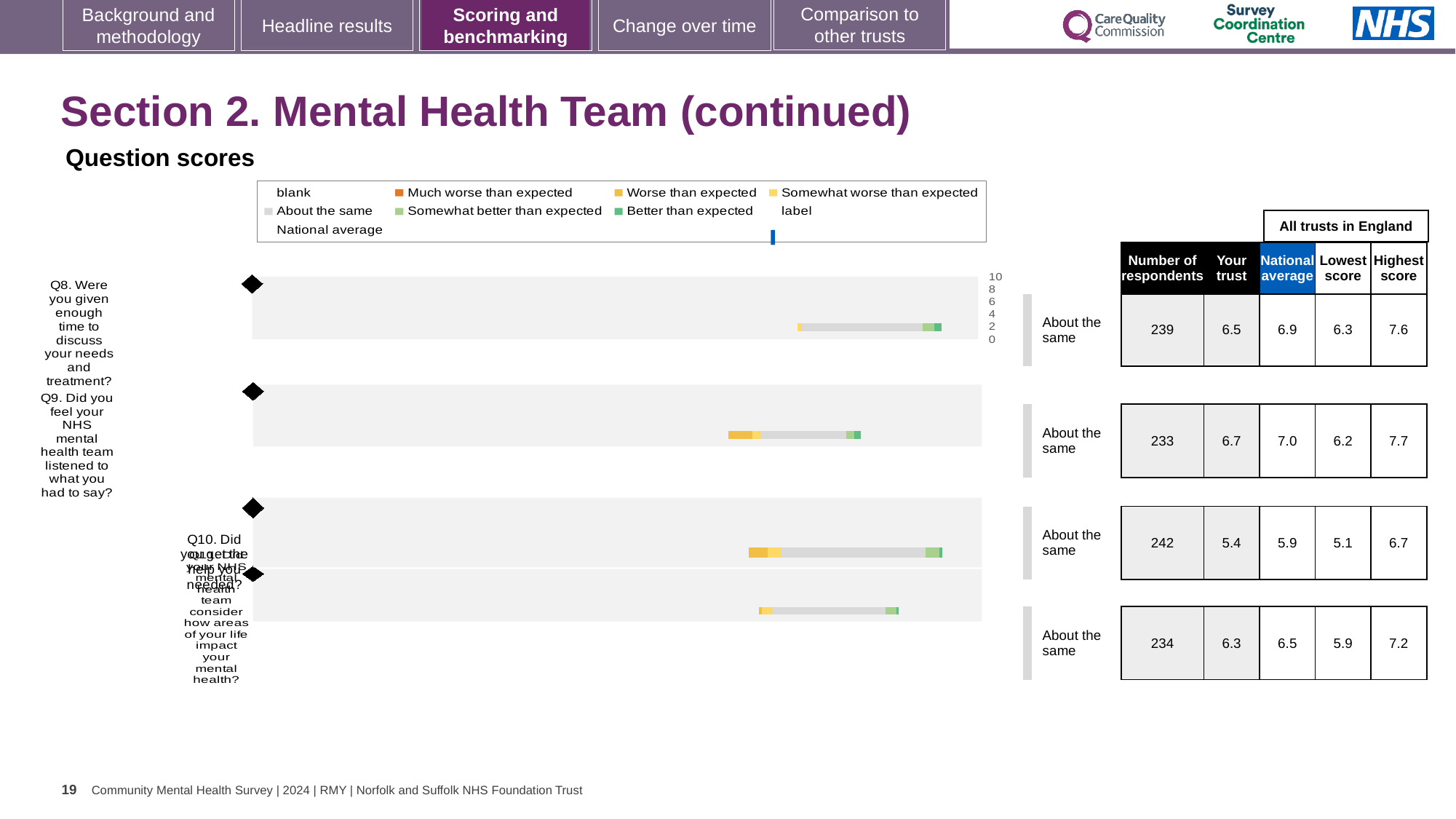
How many respondents answered Q10 (Did you get the help you needed?)? 242 What benchmark category is shown for Q9? About the same Which question has the highest number of respondents? Q10 What is the lowest score among all trusts in England for Q10? 5.1 Which has the higher 'Your trust' score, Q8 or Q9? Q9 What is the highest score among all trusts in England for Q8? 7.6 What is the 'Your trust' score for Q8 (Were you given enough time to discuss your needs and treatment?)? 6.5 What is the national average for Q9 (Did you feel your NHS mental health team listened to what you had to say?)? 7.0 How many questions (bars) are plotted in the chart? 4 What is the difference between the national average and the 'Your trust' score for Q8? 0.4 What kind of chart is shown on the slide? bar chart Which question has the lowest 'Your trust' score? Q10